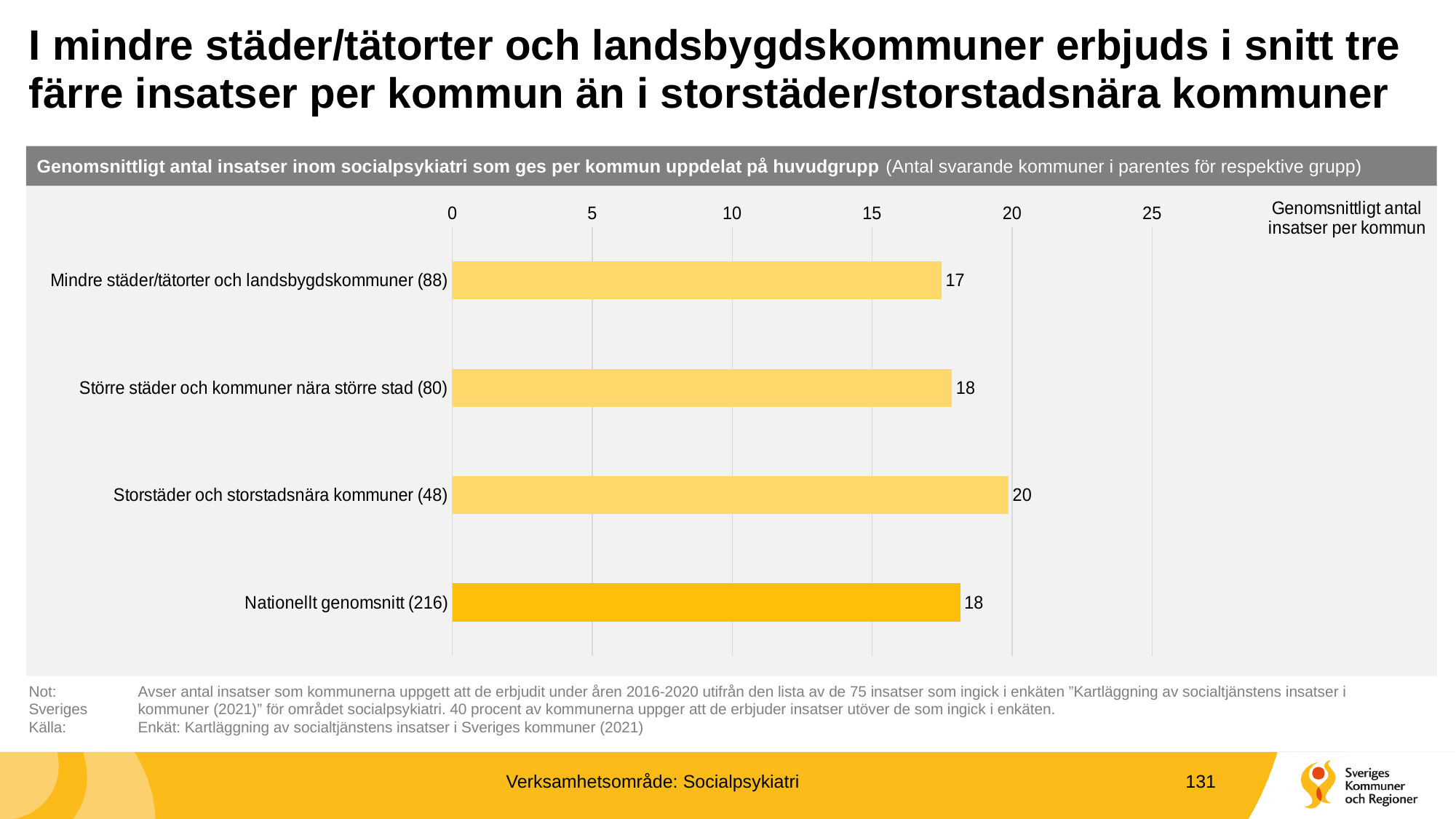
What is the difference between the values for Storstäder och storstadsnära kommuner (48) and Mindre städer/tätorter och landsbygdskommuner (88)? 3 Which bar is shown in a darker orange colour than the others? Nationellt genomsnitt (216) What is the average number of insatser per kommun for Mindre städer/tätorter och landsbygdskommuner (88)? 17 Which category has the lowest average number of insatser per kommun? Mindre städer/tätorter och landsbygdskommuner (88) Is the value for Storstäder och storstadsnära kommuner (48) greater or less than 15? greater What is the value shown for Större städer och kommuner nära större stad (80)? 18 What is the value shown for Storstäder och storstadsnära kommuner (48)? 20 Which category has the highest average number of insatser per kommun? Storstäder och storstadsnära kommuner (48) How many categories (bars) are shown in the chart? 4 What kind of chart is shown on the slide? Bar chart Which is larger: the value for Storstäder och storstadsnära kommuner (48) or the value for Nationellt genomsnitt (216)? Storstäder och storstadsnära kommuner (48) What is the value shown for Nationellt genomsnitt (216)? 18